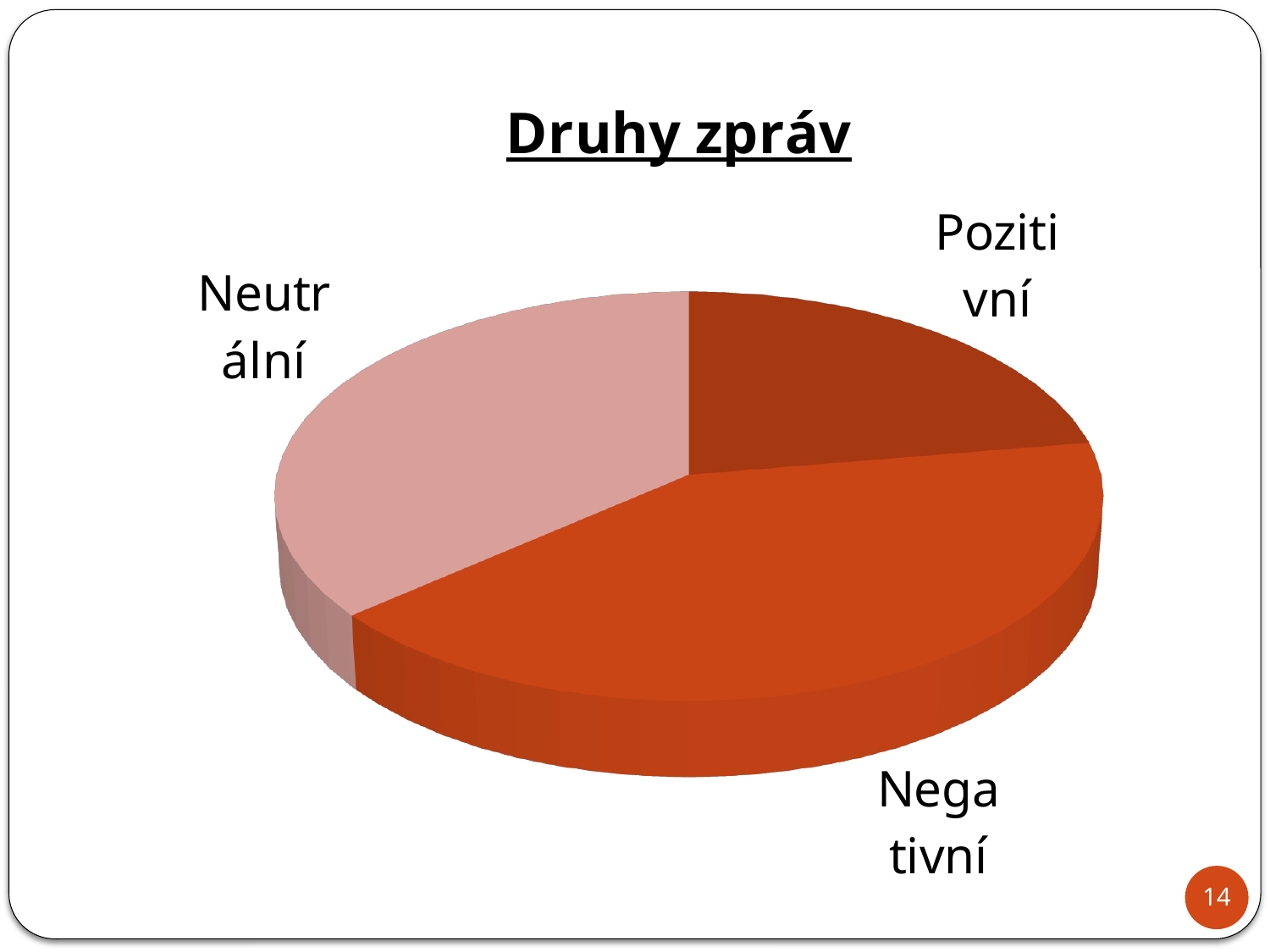
What kind of chart is shown on the slide? pie chart Which category has the largest slice of the pie? Negativní How many slices does the pie chart have? 3 What is the title of the chart? Druhy zpráv Which category is shown in the light pink slice? Neutrální Which category has the smallest slice of the pie? Pozitivní Which slice is larger, Neutrální or Pozitivní? Neutrální Which slice is larger, Negativní or Neutrální? Negativní